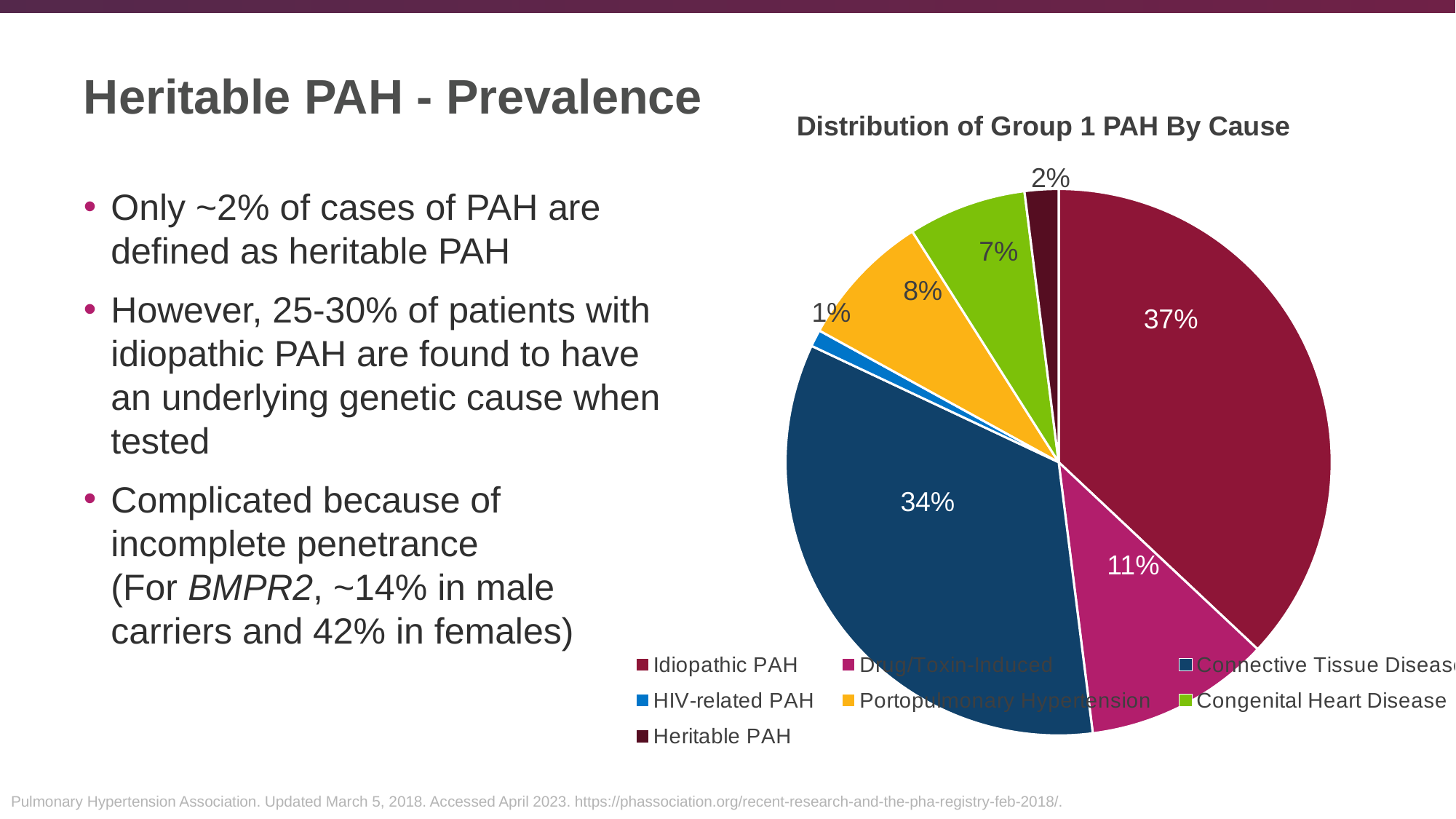
What colour represents Congenital Heart Disease in the pie chart? Green What type of chart is shown on the slide? Pie chart What share of Group 1 PAH is Heritable PAH? 2% What share of Group 1 PAH is Idiopathic PAH? 37% Which has a larger share, Drug/Toxin-Induced or Congenital Heart Disease? Drug/Toxin-Induced Which cause has the smallest share of Group 1 PAH? HIV-related PAH What is the title of the chart? Distribution of Group 1 PAH By Cause Which cause has the largest share of Group 1 PAH? Idiopathic PAH What share of Group 1 PAH is Portopulmonary Hypertension? 8% What is the difference in percentage points between Idiopathic PAH and Connective Tissue Disease? 3 How many causes are shown in the pie chart? 7 What share of Group 1 PAH is Connective Tissue Disease? 34%